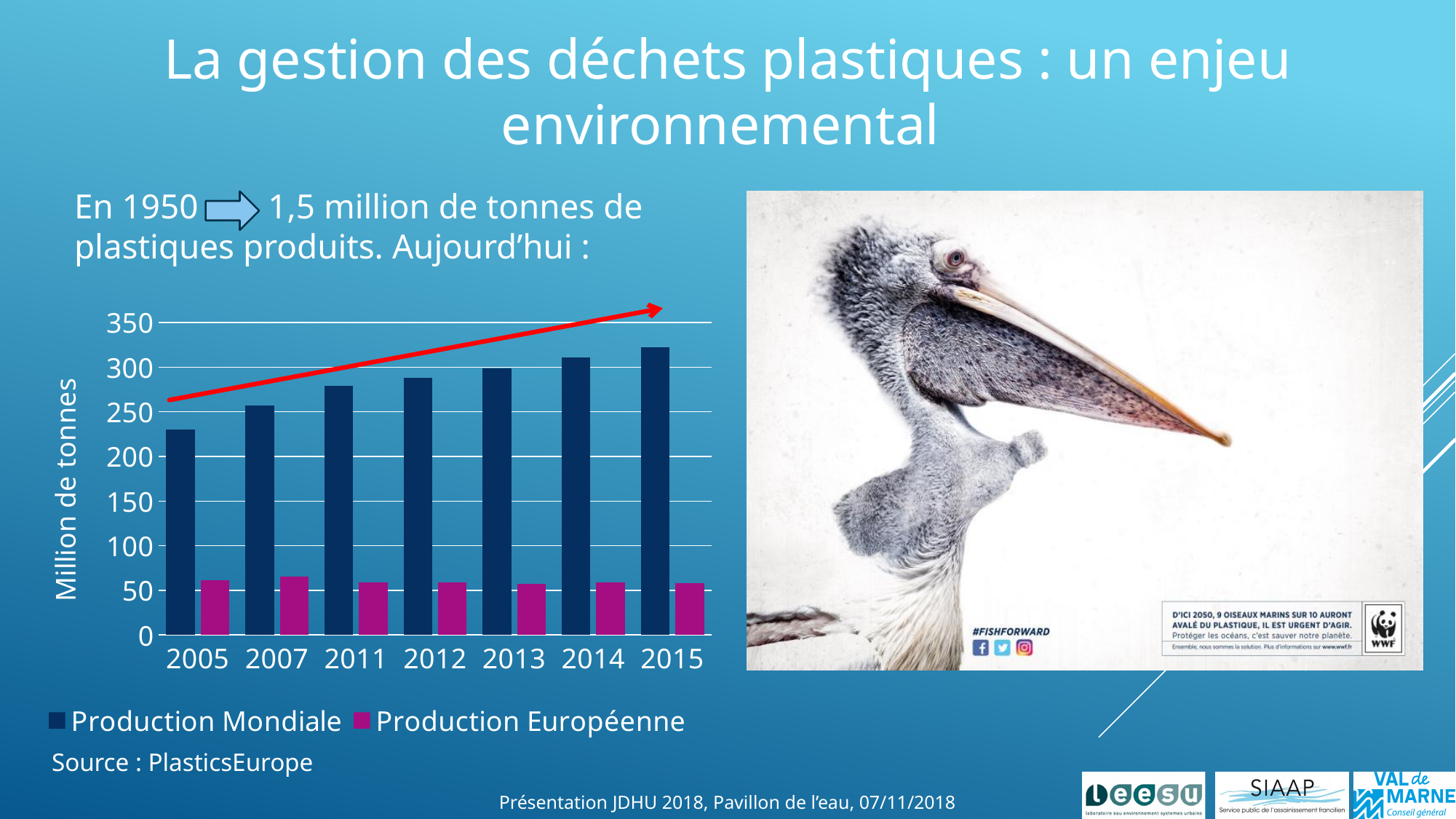
What kind of chart is shown on the slide? bar chart Is the value for Production Mondiale in 2015 greater or less than 300? greater Is the value for Production Européenne in 2013 greater or less than 100? less Is the value for Production Mondiale in 2005 greater or less than 250? less In which year is Production Européenne highest? 2007 Does Production Mondiale rise or fall from 2005 to 2015? rise How many years are shown on the x axis of the chart? 7 Which is larger in 2012, Production Mondiale or Production Européenne? Production Mondiale In which year is Production Mondiale lowest? 2005 How many series does the chart legend list? 2 What is the label on the y axis of the chart? Million de tonnes In which year is Production Mondiale highest? 2015